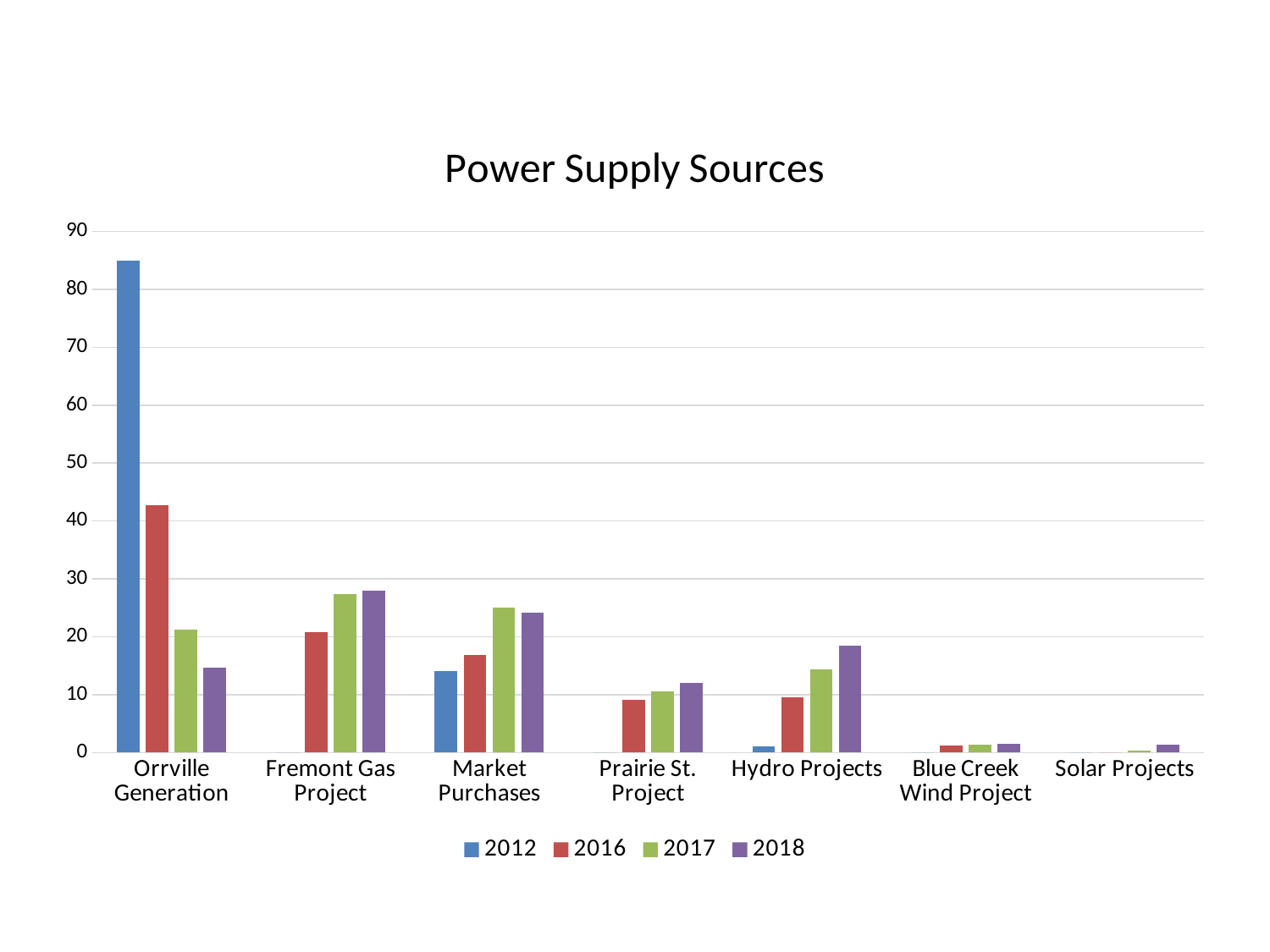
Is the 2012 value for Orrville Generation greater or less than 80? greater Which is larger, the 2017 value for Fremont Gas Project or the 2017 value for Orrville Generation? Fremont Gas Project Is the 2016 value for Orrville Generation greater or less than 40? greater Which category has the highest value for the 2012 series? Orrville Generation Do the values for Orrville Generation rise or fall from 2012 to 2018? fall How many series does the legend list? 4 What is the title of the chart? Power Supply Sources Do the values for Hydro Projects rise or fall from 2012 to 2018? rise Is the 2017 value for Market Purchases greater or less than 20? greater How many power supply source categories are shown on the x axis? 7 What kind of chart is shown on the slide? bar chart Which category has the highest value for the 2018 series? Fremont Gas Project